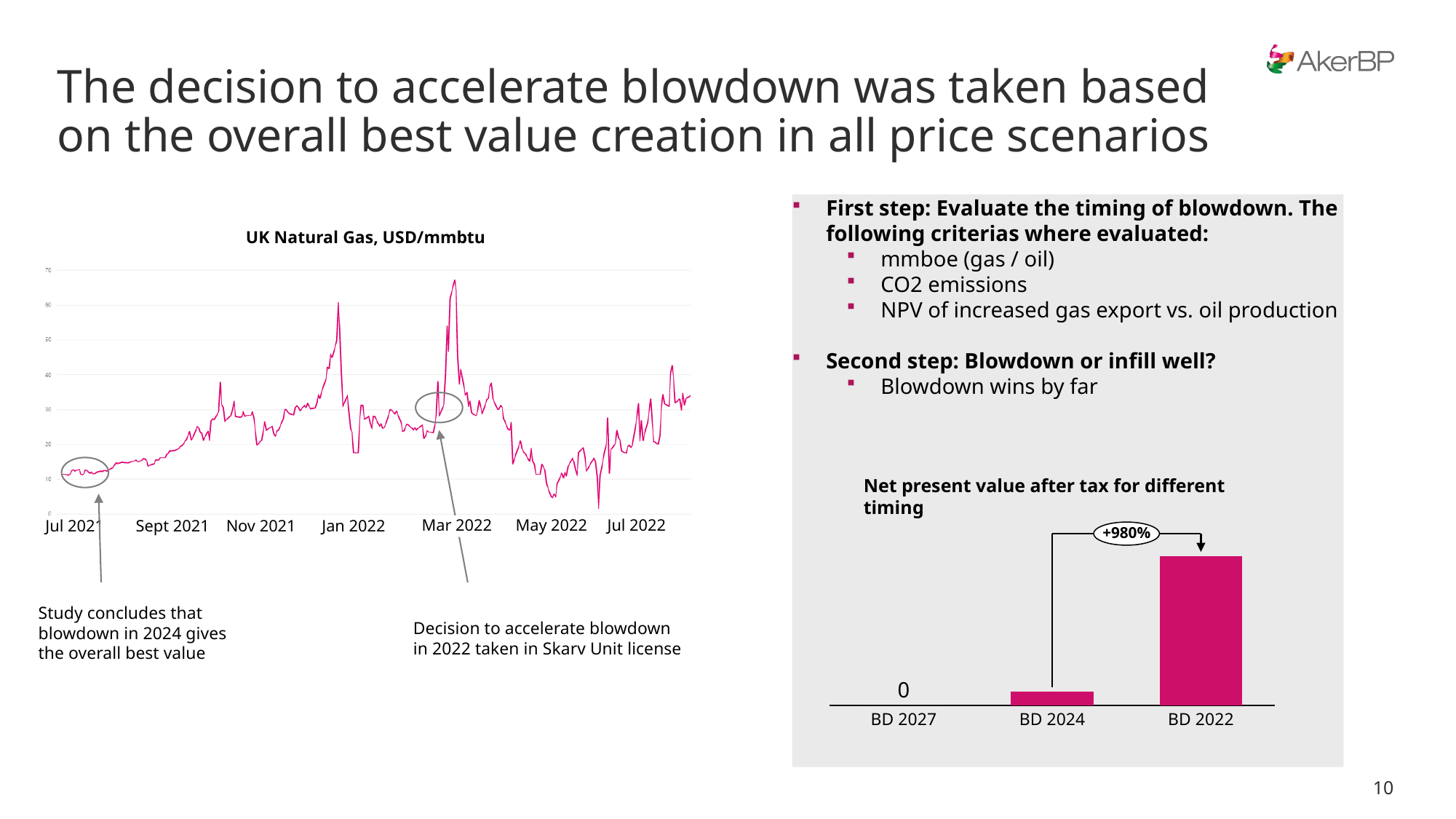
In the 'Net present value after tax for different timing' chart, which category has the highest value? BD 2022 In the 'Net present value after tax for different timing' chart, how many categories are shown on the x axis? 3 In the 'Net present value after tax for different timing' chart, which category has the lowest value? BD 2027 In the 'UK Natural Gas, USD/mmbtu' chart, does the price rise or fall between Jul 2021 and Nov 2021? rise In the 'UK Natural Gas, USD/mmbtu' chart, is the value at Jul 2021 greater or less than 20? less In the 'Net present value after tax for different timing' chart, which is larger, BD 2024 or BD 2022? BD 2022 What type of chart is the 'UK Natural Gas, USD/mmbtu' chart? line chart What is the title of the line chart on the left of the slide? UK Natural Gas, USD/mmbtu In the 'Net present value after tax for different timing' chart, what value is shown for BD 2027? 0 In the 'UK Natural Gas, USD/mmbtu' chart, is the peak value reached around Mar 2022 greater or less than 60? greater In the 'Net present value after tax for different timing' chart, what percentage change is annotated between BD 2024 and BD 2022? +980% What type of chart is the 'Net present value after tax for different timing' chart? bar chart